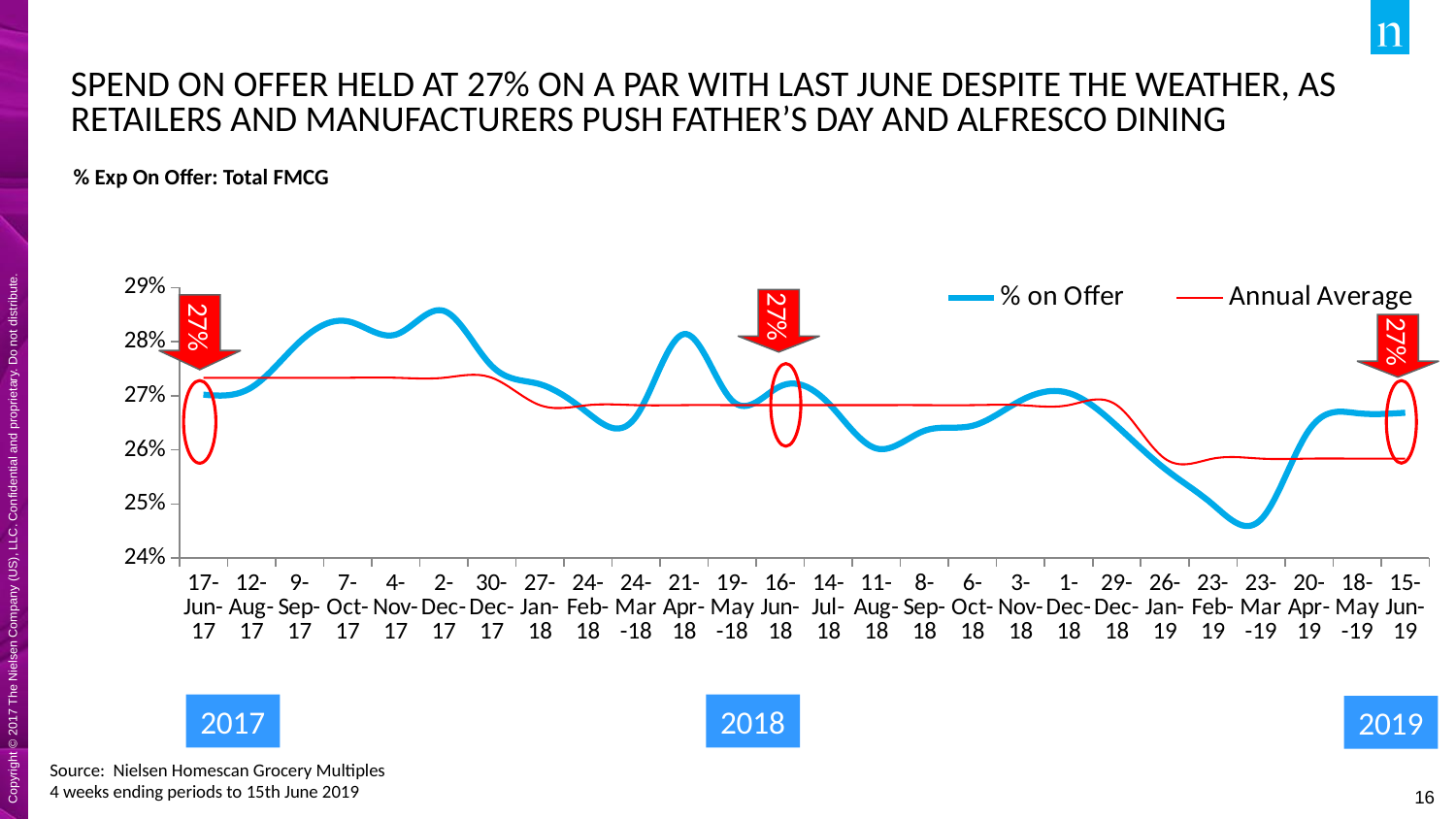
Is the % on Offer value for 26-Jan-19 greater or less than 26%? less Which period has the lowest % on Offer value? 23-Mar-19 Which is larger, the % on Offer value for 17-Jun-17 or for 26-Jan-19? 17-Jun-17 How many dated periods are shown along the x axis of the chart? 26 What kind of chart is shown on the slide? line chart How many series does the chart legend list? 2 Which period has the highest % on Offer value? 2-Dec-17 What is the title of the chart? % Exp On Offer: Total FMCG Does the % on Offer line rise or fall between 29-Dec-18 and 23-Mar-19? fall Is the % on Offer value for 2-Dec-17 greater or less than 28%? greater What are the two series named in the chart legend? % on Offer and Annual Average Is the % on Offer value for 23-Mar-19 greater or less than 25%? less